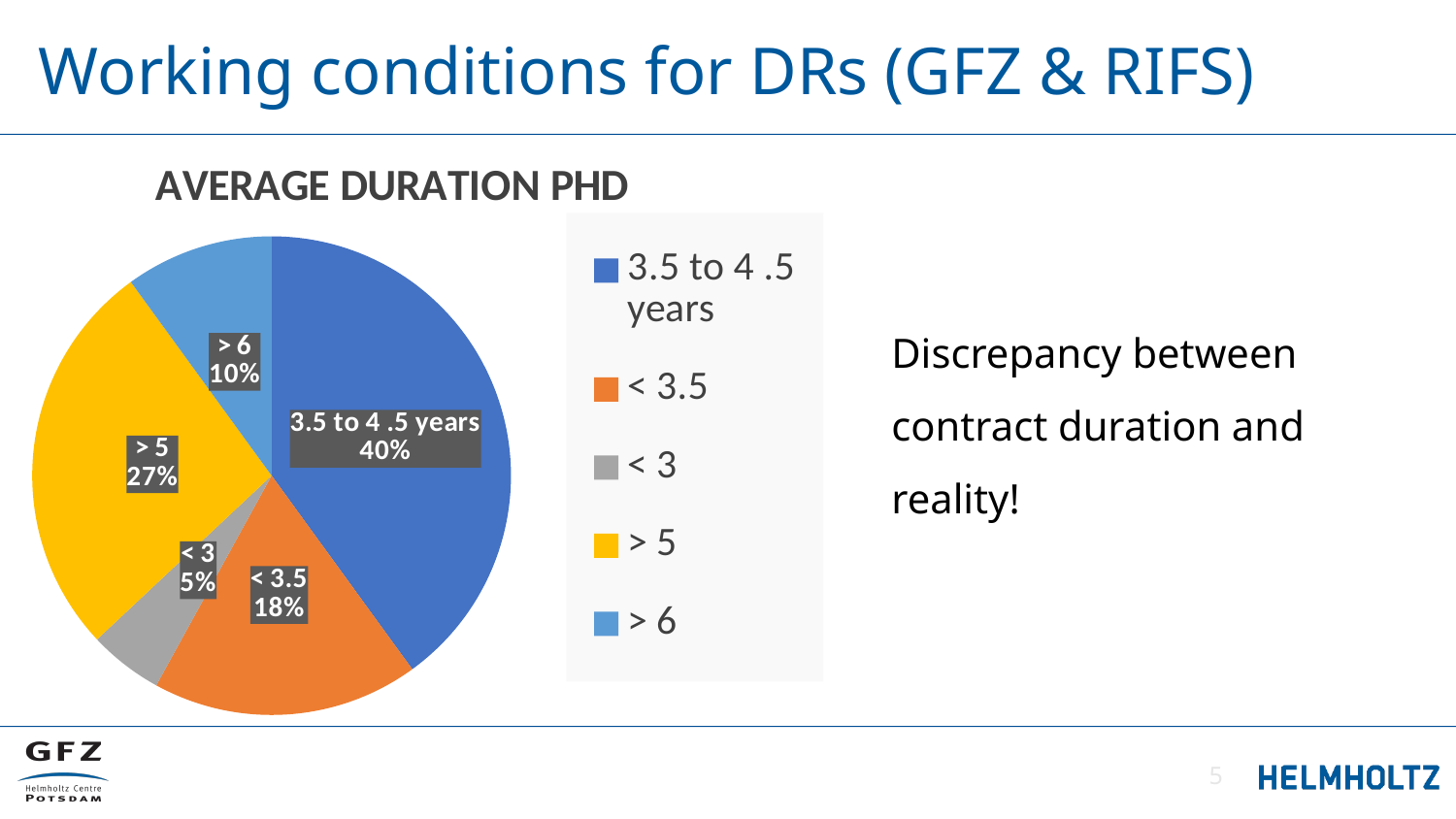
Which category has the smallest slice of the pie? < 3 What kind of chart is shown on the slide? Pie chart Which category has the largest slice of the pie? 3.5 to 4 .5 years What is the value shown for the '< 3.5' category? 18% What colour is the '> 5' slice? Yellow What is the value shown for the '> 6' category? 10% What is the value shown for the '> 5' category? 27% What share of the pie does the '3.5 to 4 .5 years' slice represent? 40% What is the title of the chart? AVERAGE DURATION PHD What is the difference between the '> 5' and '< 3.5' slices? 9% How many categories does the pie chart show? 5 Which is larger, the '> 6' slice or the '< 3' slice? > 6